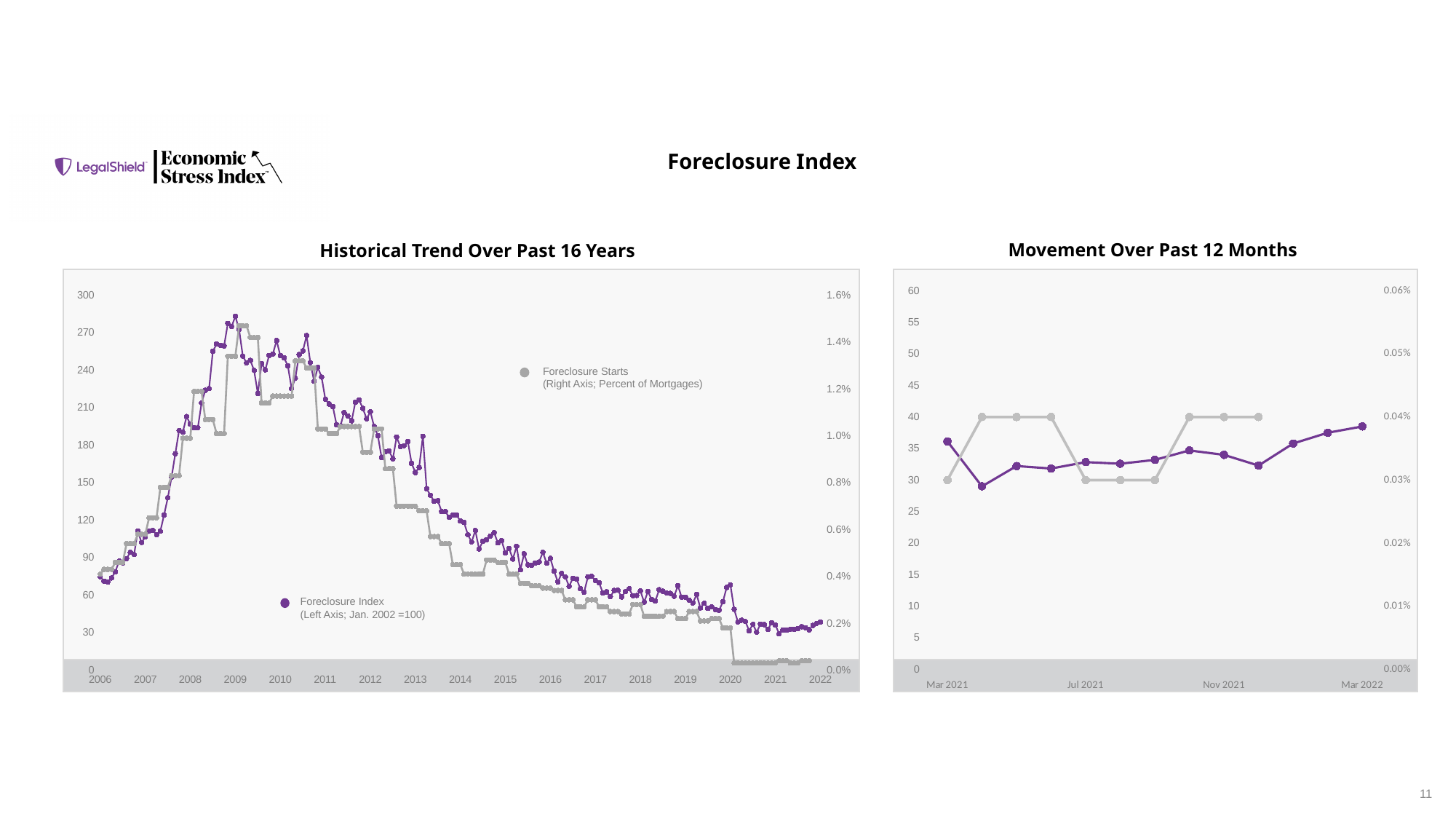
How many series does the legend of the 'Historical Trend Over Past 16 Years' chart list? 2 In the 'Movement Over Past 12 Months' chart, is the purple line's value at Jul 2021 greater or less than 35? less In the 'Movement Over Past 12 Months' chart, how many points does the purple line have? 13 In the 'Historical Trend Over Past 16 Years' chart, is the peak Foreclosure Index value around 2009 greater or less than 240? greater In the 'Historical Trend Over Past 16 Years' chart, is the Foreclosure Index value at the start of 2006 greater or less than 90? less In the 'Historical Trend Over Past 16 Years' chart, which axis does the Foreclosure Starts series use? Right axis What kind of chart is the 'Historical Trend Over Past 16 Years' chart? line chart In the 'Historical Trend Over Past 16 Years' chart, does the Foreclosure Index rise or fall between 2010 and 2020? fall In the 'Movement Over Past 12 Months' chart, what is the gray line's value at Mar 2021? 0.03% In the 'Historical Trend Over Past 16 Years' chart, is the Foreclosure Index higher in 2008 or in 2016? 2008 What kind of chart is the 'Movement Over Past 12 Months' chart? line chart